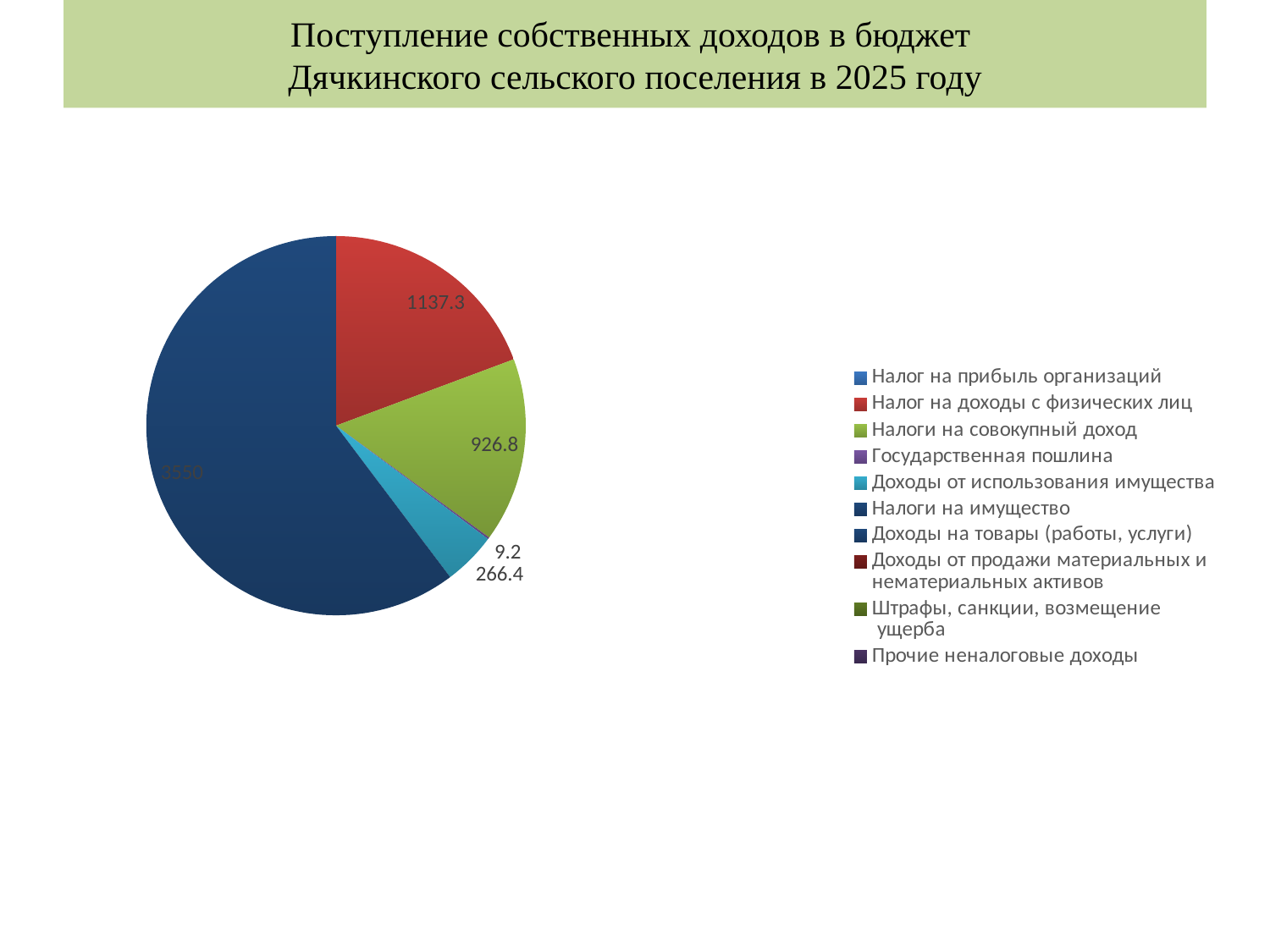
What is the difference between the values for Налог на доходы с физических лиц and Налоги на совокупный доход? 210.5 Which labelled category has the smallest slice of the pie? Государственная пошлина What is the value for Налоги на совокупный доход? 926.8 What is the value for Налог на доходы с физических лиц? 1137.3 What type of chart is shown on the slide? pie chart What is the value for Налоги на имущество? 3550 What is the value for Государственная пошлина? 9.2 Which is larger: Налоги на совокупный доход or Доходы от использования имущества? Налоги на совокупный доход Which category has the largest slice of the pie? Налоги на имущество What is the title of the slide? Поступление собственных доходов в бюджет Дячкинского сельского поселения в 2025 году What is the value for Доходы от использования имущества? 266.4 How many entries does the legend list? 10